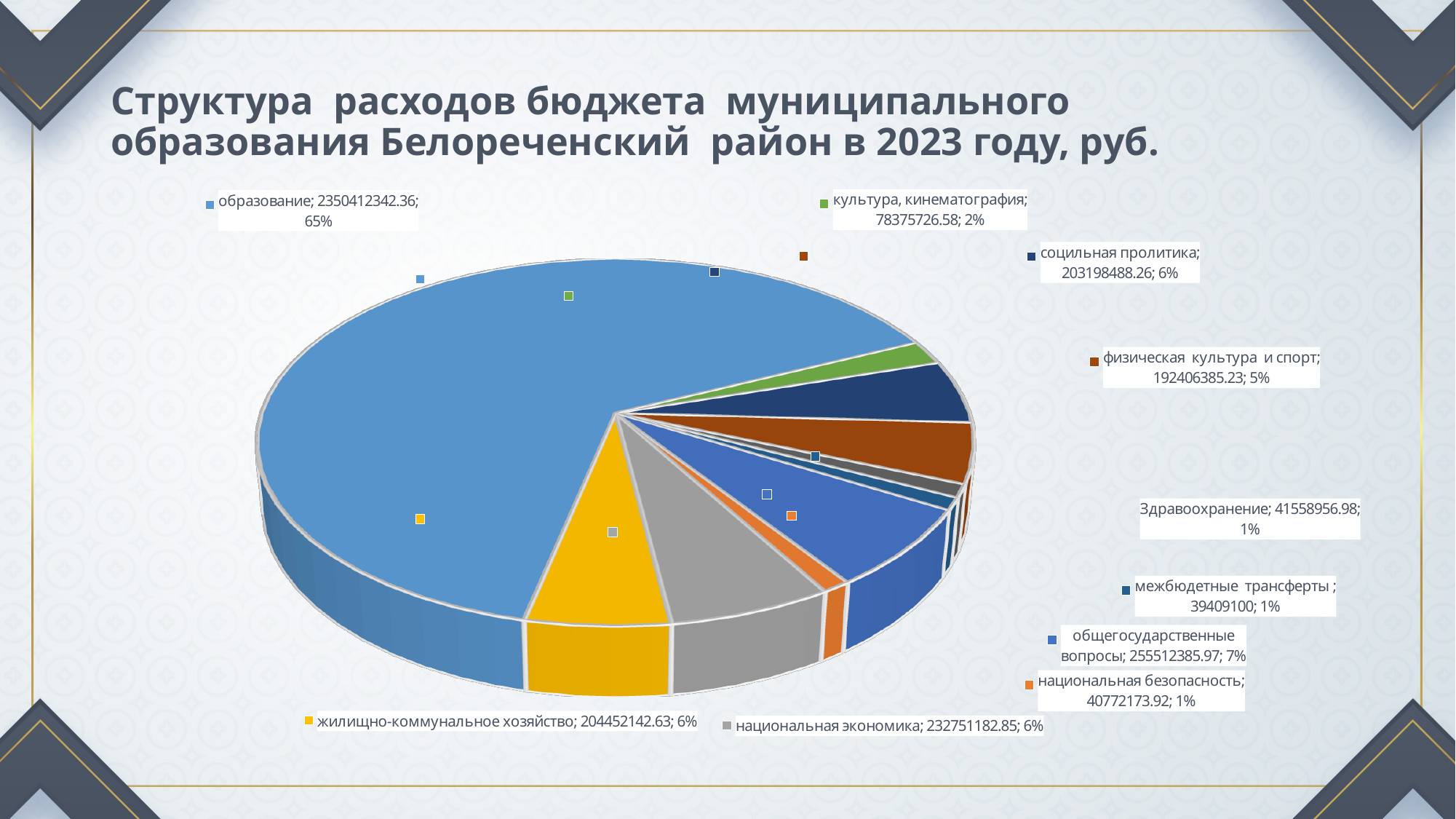
What is the difference between социльная пролитика and физическая культура и спорт? 10792103.03 What share of the pie does образование take? 65% Which is larger: Здравоохранение or национальная безопасность? Здравоохранение What is the value for Здравоохранение? 41558956.98 What kind of chart is shown on the slide? pie chart What is the title of the chart on the slide? Структура расходов бюджета муниципального образования Белореченский район в 2023 году, руб. What is the value for образование? 2350412342.36 What share of the pie does культура, кинематография take? 2% Which is larger: жилищно-коммунальное хозяйство or национальная экономика? национальная экономика Which category has the largest slice of the pie? образование What is the difference between общегосударственные вопросы and национальная экономика? 22761203.12 What is the value for общегосударственные вопросы? 255512385.97